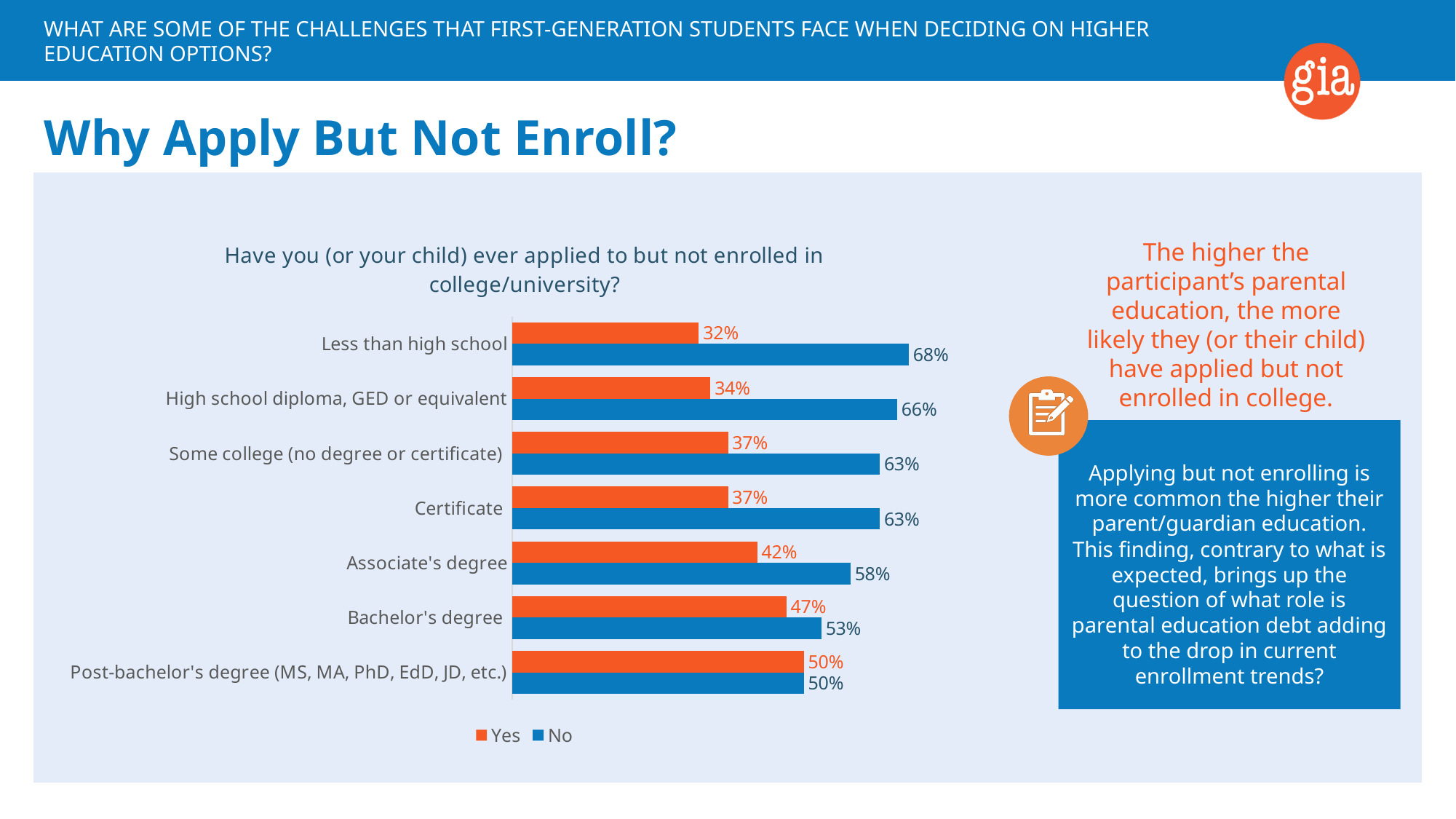
How many education categories are shown in the chart? 7 What is the "Yes" value for Less than high school? 32% What is the "Yes" value for Bachelor's degree? 47% Which is larger for High school diploma, GED or equivalent: the "Yes" value or the "No" value? No Which colour represents the "Yes" series in the chart? Orange What is the difference between the "No" and "Yes" values for Less than high school? 36% Which category has the lowest "No" value? Post-bachelor's degree (MS, MA, PhD, EdD, JD, etc.) Which category has the highest "Yes" value? Post-bachelor's degree (MS, MA, PhD, EdD, JD, etc.) How many series does the legend list? 2 Do the "Yes" values rise or fall as parental education increases from Less than high school to Post-bachelor's degree? Rise What is the "No" value for Associate's degree? 58% What kind of chart is shown on the slide? Bar chart